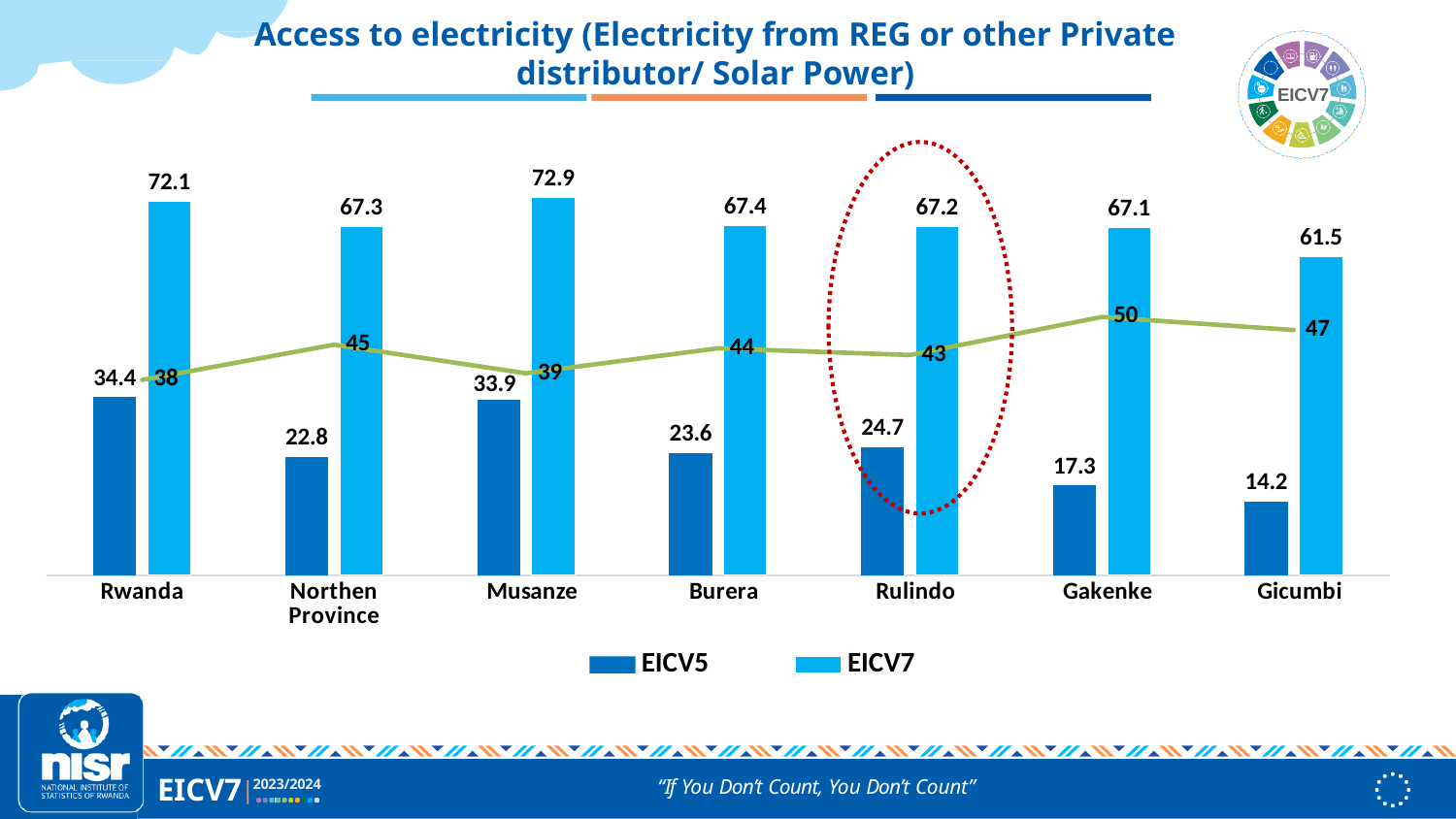
How many series does the legend list? 2 Which is larger, the EICV5 value for Burera or the EICV5 value for Gakenke? Burera What is the difference between the EICV7 and EICV5 values for Rwanda? 37.7 How many categories are shown on the x axis? 7 What kind of chart is shown on the slide? Combination bar and line chart Which category has the highest EICV7 value? Musanze Which category has the lowest EICV5 value? Gicumbi Which category is circled with a red dotted outline on the chart? Rulindo What is the EICV7 value for Musanze? 72.9 What is the EICV5 value for Gicumbi? 14.2 Do the EICV5 values rise or fall from Rulindo to Gicumbi? Fall What is the EICV5 value for Rulindo? 24.7